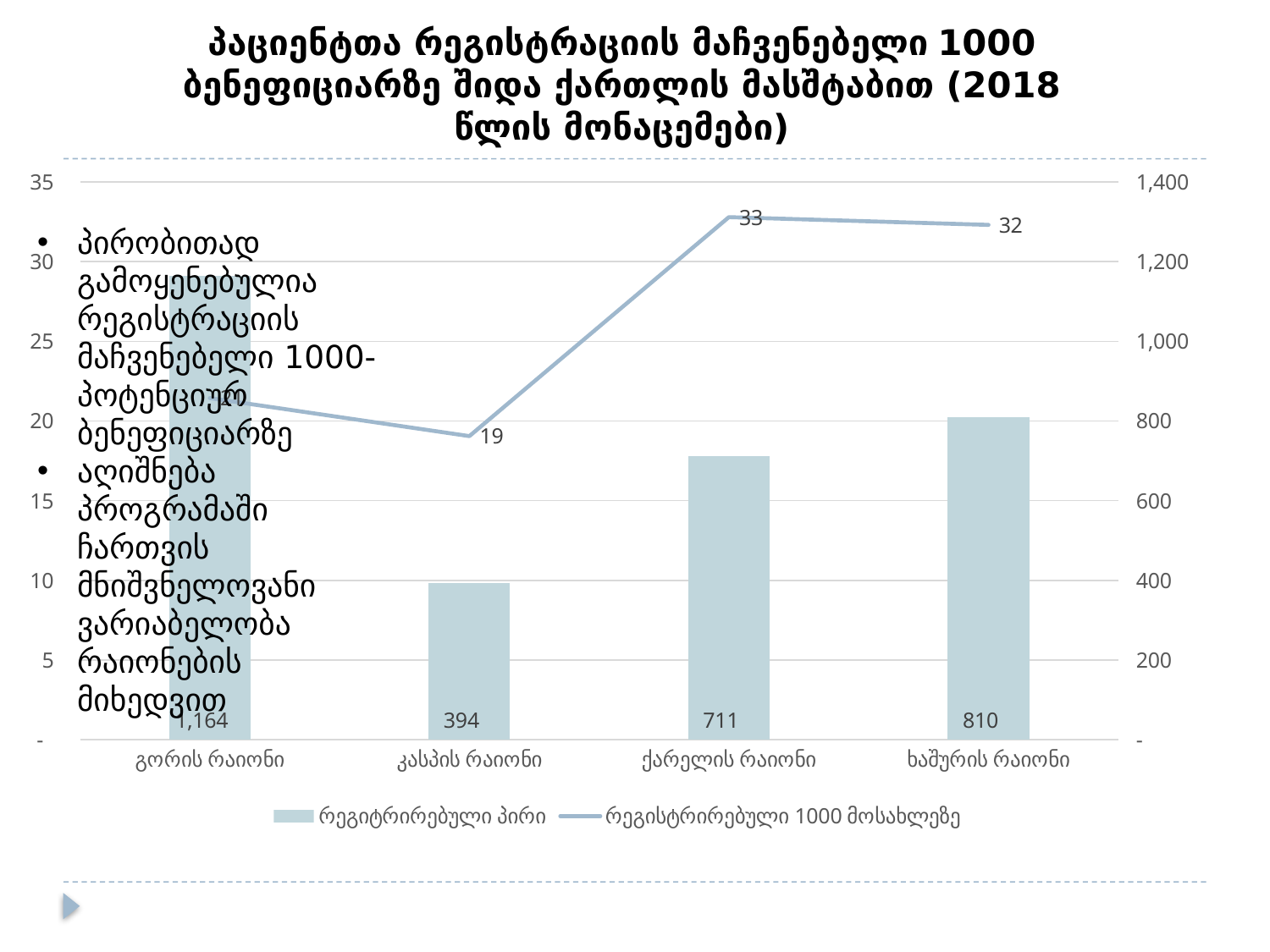
How many series does the chart legend list? 2 What is the difference between the რეგიტრირებული პირი values for გორის რაიონი and კასპის რაიონი? 770 What is the difference between the რეგიტრირებული პირი values for ხაშურის რაიონი and ქარელის რაიონი? 99 What is the value of the რეგიტრირებული პირი bar for ხაშურის რაიონი? 810 Which has a larger რეგიტრირებული პირი value, ქარელის რაიონი or ხაშურის რაიონი? ხაშურის რაიონი Which region has the lowest რეგიტრირებული პირი bar? კასპის რაიონი How many regions are shown on the x axis of the chart? 4 What is the value of the რეგიტრირებული პირი bar for კასპის რაიონი? 394 Which region has the highest რეგიტრირებული პირი bar? გორის რაიონი What is the value of the რეგისტრირებული 1000 მოსახლეზე line for კასპის რაიონი? 19 What is the value of the რეგისტრირებული 1000 მოსახლეზე line for ქარელის რაიონი? 33 Is the რეგისტრირებული 1000 მოსახლეზე value for გორის რაიონი greater or less than 25? less